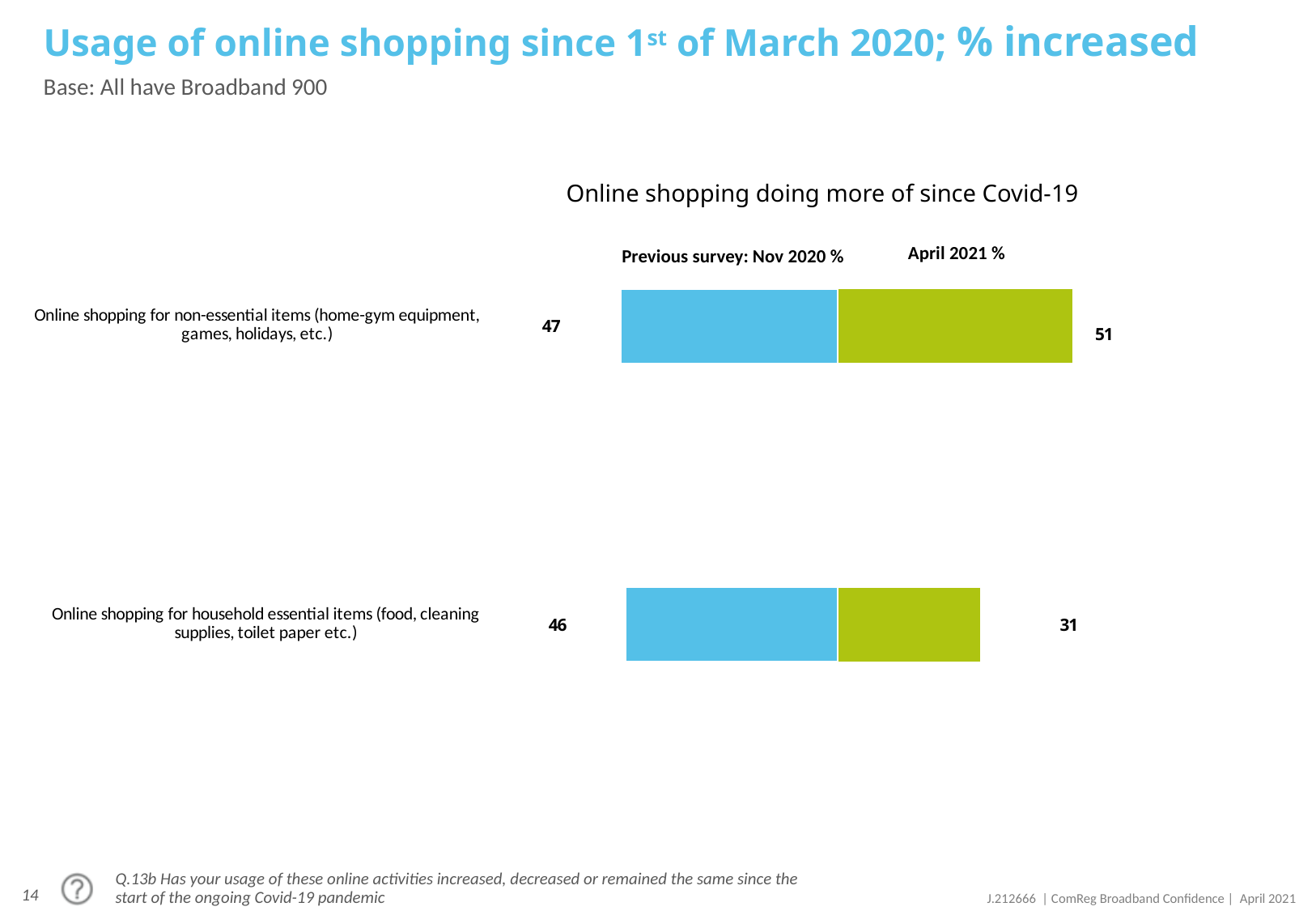
What is the difference between the April 2021 values for non-essential items and household essential items? 20 What is the April 2021 % value for online shopping for household essential items? 31 What is the difference between the Nov 2020 and April 2021 values for online shopping for household essential items? 15 What is the Previous survey: Nov 2020 % value for online shopping for non-essential items? 47 How many series does the chart show? 2 Which category has the highest April 2021 % value? Online shopping for non-essential items (home-gym equipment, games, holidays, etc.) For online shopping for non-essential items, which is larger: the Nov 2020 value or the April 2021 value? April 2021 What is the Previous survey: Nov 2020 % value for online shopping for household essential items? 46 Which category has the lowest April 2021 % value? Online shopping for household essential items (food, cleaning supplies, toilet paper etc.) What is the April 2021 % value for online shopping for non-essential items? 51 What kind of chart is shown on the slide? Bar chart How many categories are shown in the chart? 2